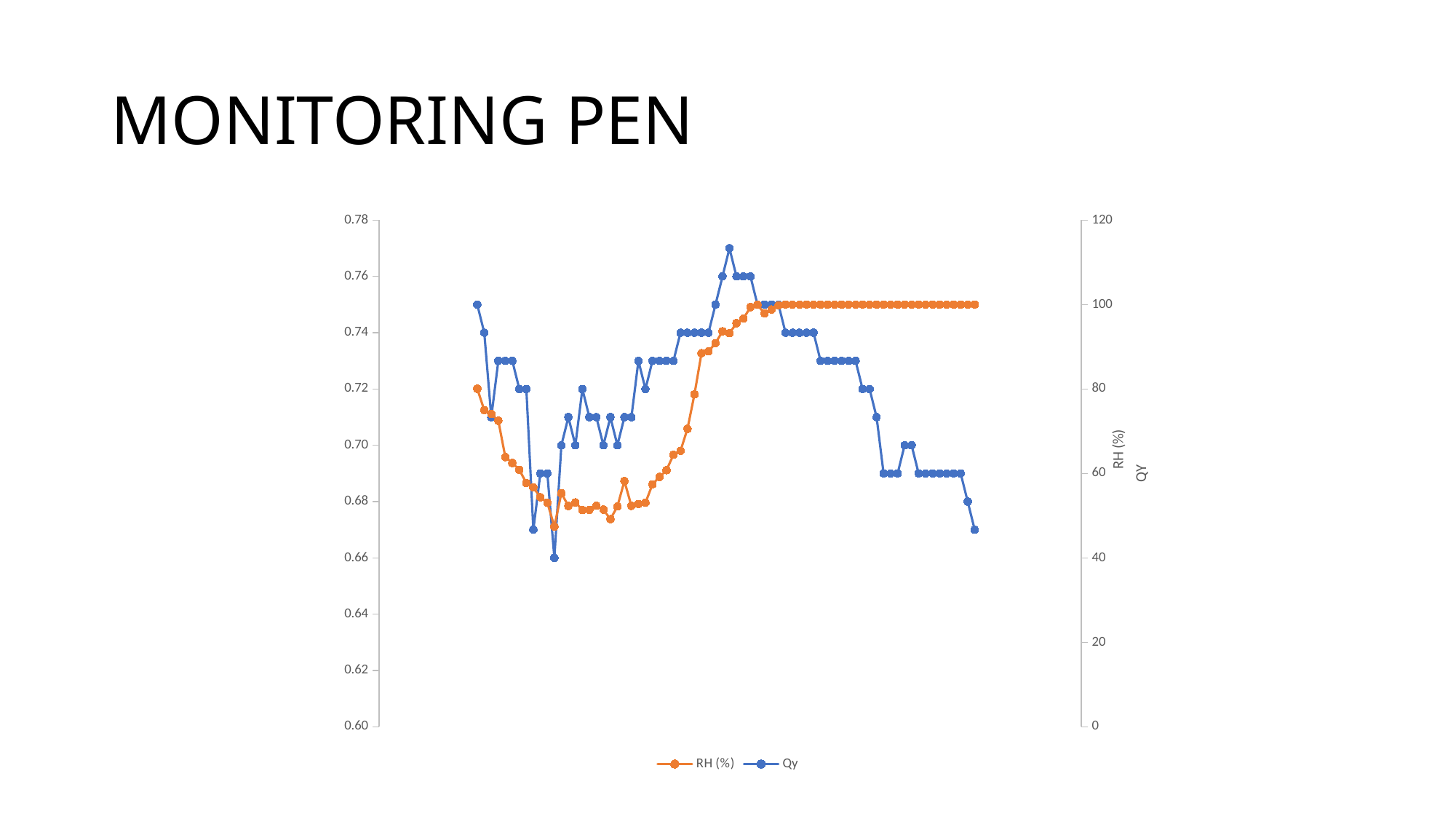
Which colour is used for the Qy series in the chart? blue Is the lowest point of the RH (%) line greater or less than 60 on the right-hand axis? less What kind of chart is shown on the slide? line chart On the right-hand axis, at what value does the RH (%) line plateau at the right end of the chart? 100 Is the highest point of the Qy line greater or less than 0.76 on the left-hand axis? greater On the left-hand axis, what is the lowest value reached by the Qy line? 0.66 Does the RH (%) series end higher or lower than it starts, reading left to right? higher At the far right end of the chart, which series is plotted higher, RH (%) or Qy? RH (%) What is the highest tick value shown on the left-hand vertical axis? 0.78 How many series does the chart legend list? 2 What are the two series named in the chart legend? RH (%) and Qy Does the Qy series end higher or lower than it starts, reading left to right? lower